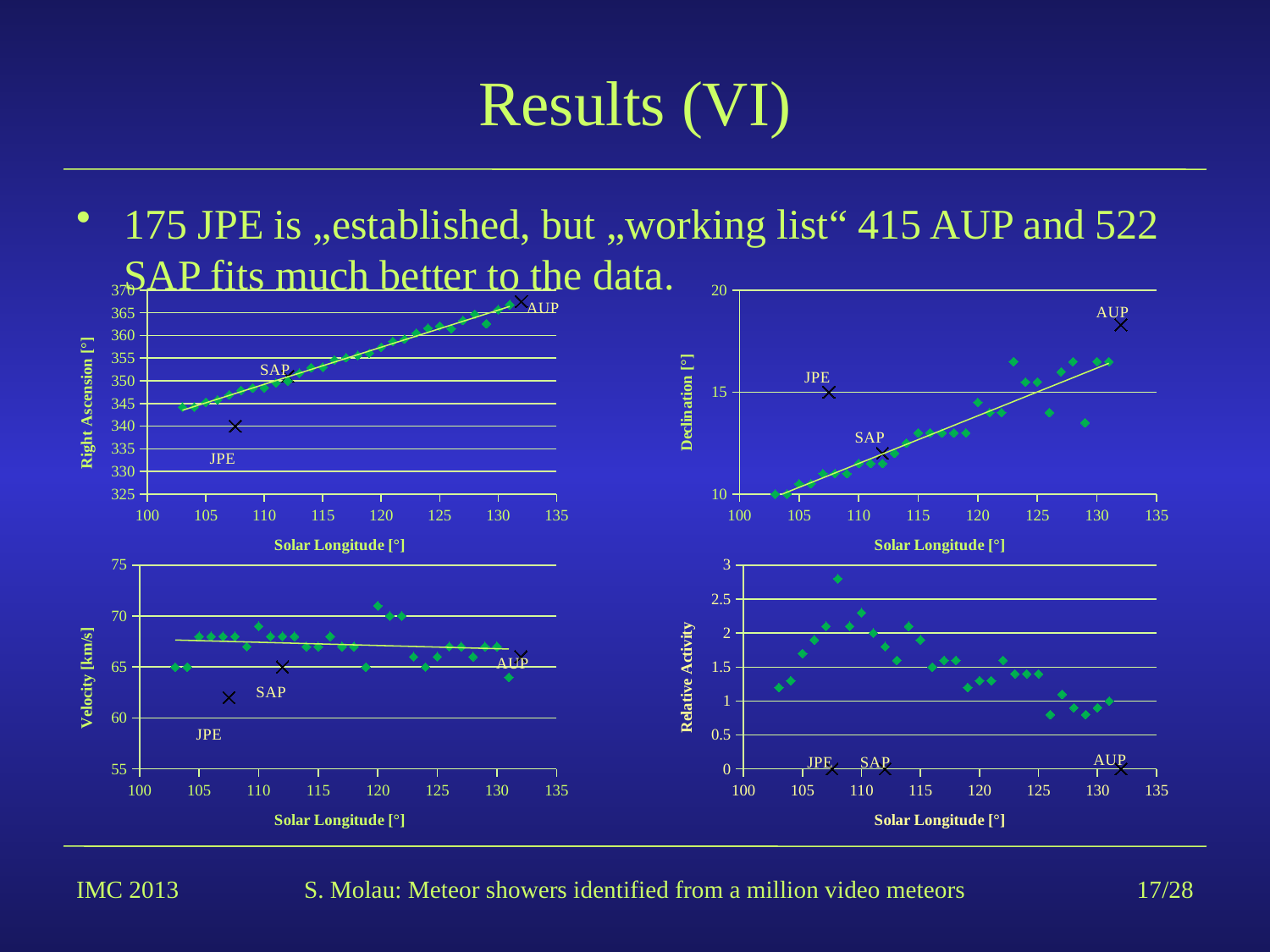
In the Declination chart (top-right), is the value of the AUP marker greater or less than 15? greater What is the y-axis title of the bottom-left chart? Velocity [km/s] In the Declination chart (top-right), is the value of the SAP marker greater or less than 15? less In the Declination chart (top-right), do the plotted values rise or fall as solar longitude increases? rise In the Right Ascension chart (top-left), is the value of the JPE marker greater or less than 345? less What is the x-axis title shared by all four charts on the slide? Solar Longitude [°] In the Right Ascension chart (top-left), do the plotted values rise or fall as solar longitude increases? rise What kind of chart is the Right Ascension chart in the top-left of the slide? scatter chart How many charts are shown on the slide? 4 In the Relative Activity chart (bottom-right), do the plotted values rise or fall between solar longitude 110 and 130? fall